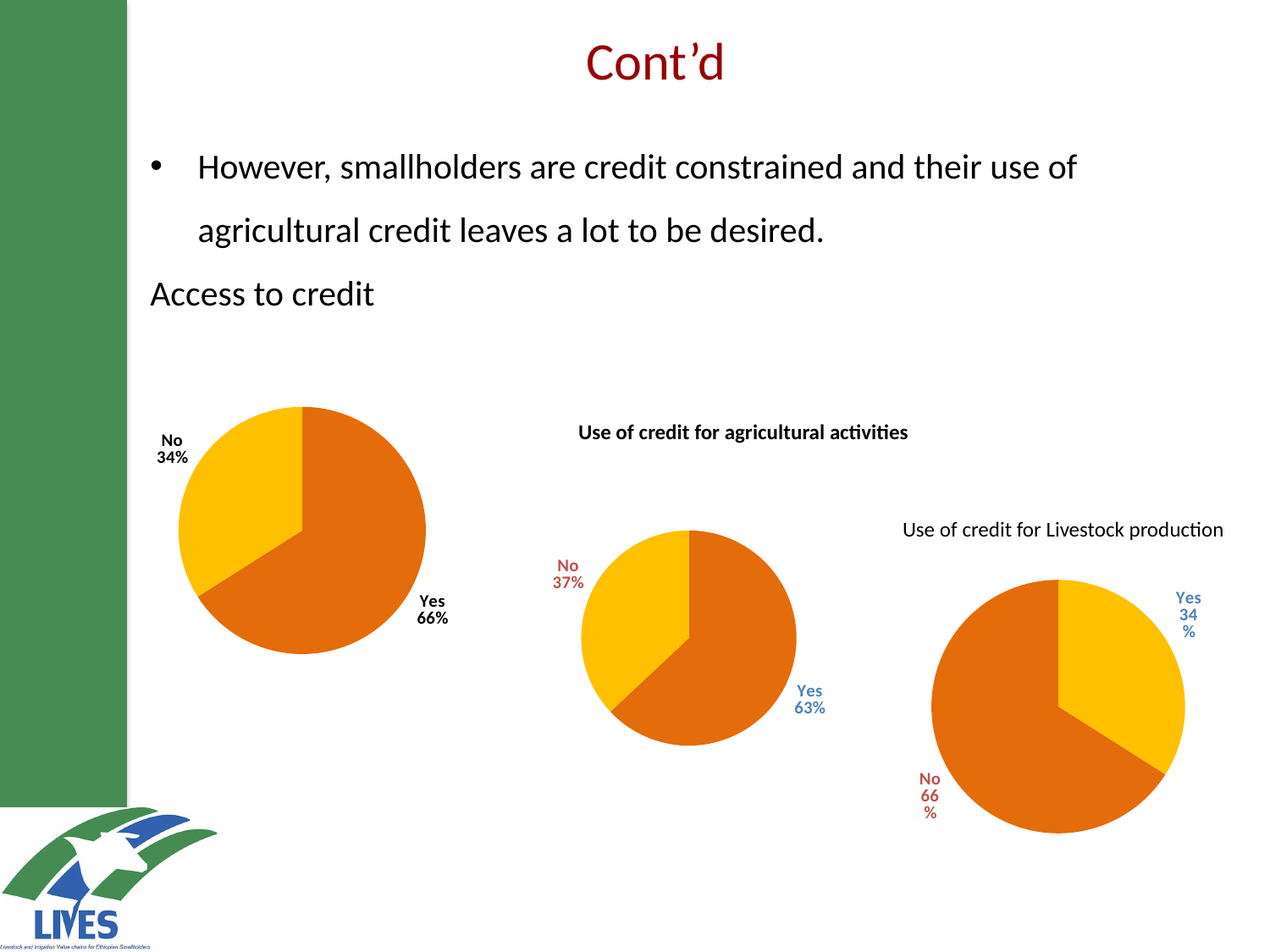
In the 'Access to credit' pie chart on the left, what share of respondents answered No? 34% In the 'Access to credit' pie chart on the left, what share of respondents answered Yes? 66% In the 'Use of credit for Livestock production' pie chart, what percentage is labelled Yes? 34% In the 'Use of credit for agricultural activities' pie chart, what percentage is labelled No? 37% In the 'Use of credit for Livestock production' pie chart, what percentage is labelled No? 66% In the 'Use of credit for Livestock production' pie chart, which slice is larger, Yes or No? No In the 'Access to credit' pie chart on the left, what is the difference in percentage points between the Yes and No slices? 32 How many pie charts are shown on the slide? 3 In the 'Use of credit for agricultural activities' pie chart, what percentage is labelled Yes? 63% How many slices does the 'Use of credit for agricultural activities' pie chart have? 2 In the 'Use of credit for agricultural activities' pie chart, which slice is the largest? Yes What type of chart is used for 'Use of credit for Livestock production'? Pie chart